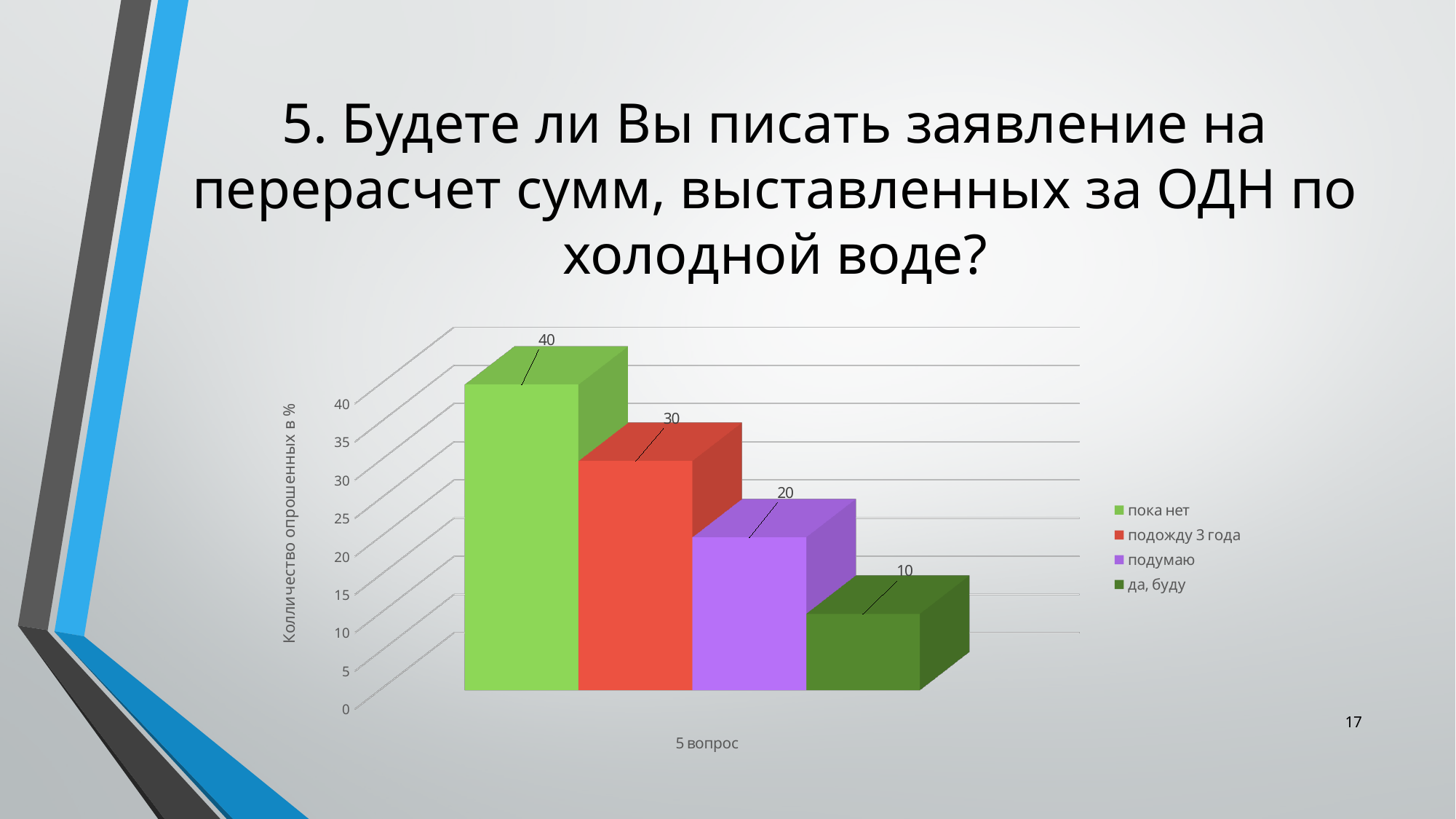
What value is shown for "подожду 3 года"? 30 What value is shown for "пока нет"? 40 What kind of chart is shown on the slide? bar chart Which is larger, the value for "подожду 3 года" or the value for "подумаю"? подожду 3 года Which series has the highest value? пока нет What value is shown for "подумаю"? 20 What is the label of the vertical axis? Колличество опрошенных в % Which series has the lowest value? да, буду What is the difference between the values for "пока нет" and "да, буду"? 30 What value is shown for "да, буду"? 10 What is the category label shown below the bars? 5 вопрос How many series does the legend list? 4